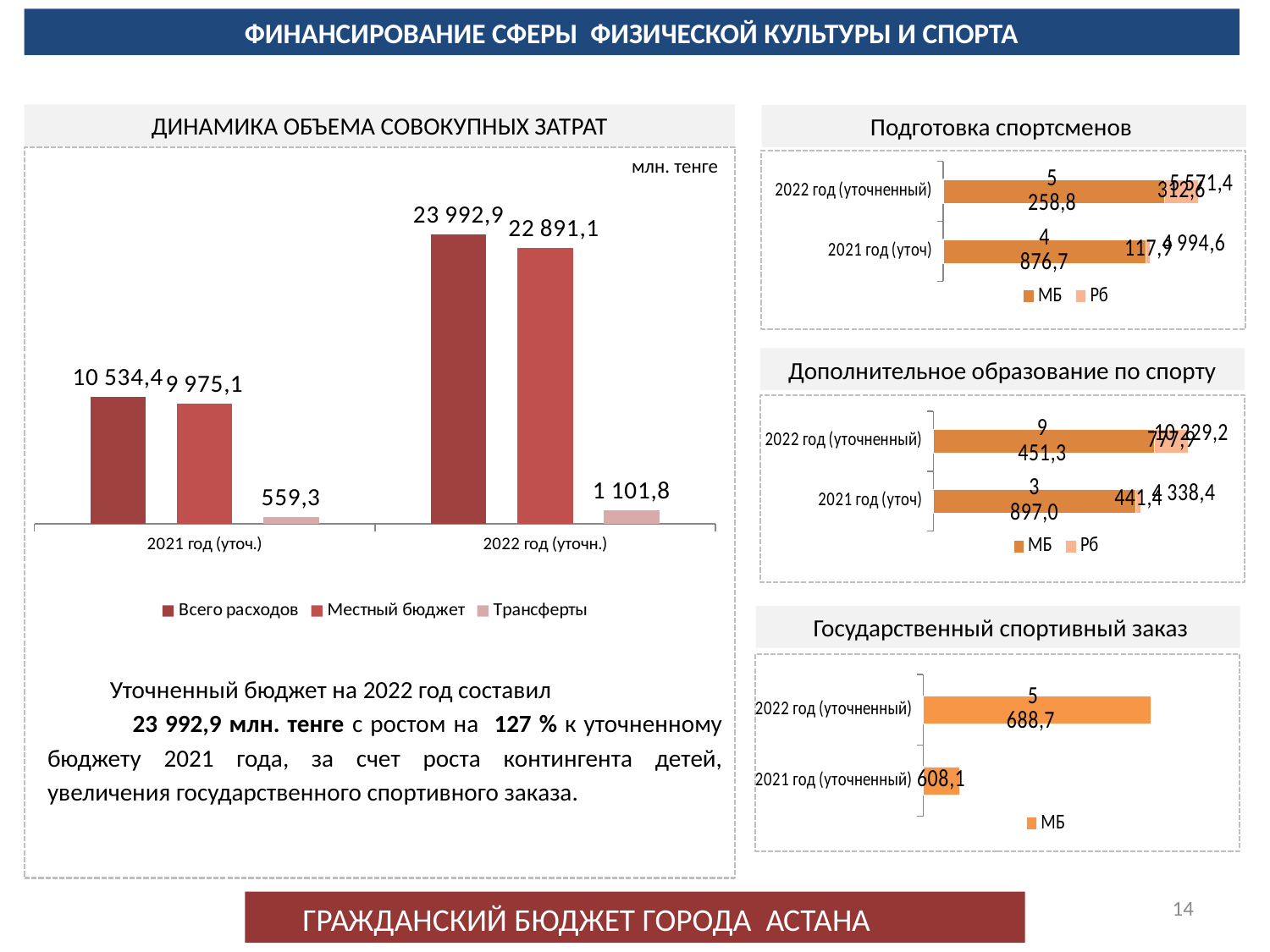
In the chart 'ДИНАМИКА ОБЪЕМА СОВОКУПНЫХ ЗАТРАТ', what is the difference between 'Всего расходов' for 2022 год (уточн.) and for 2021 год (уточ.)? 13 458,5 In the chart 'ДИНАМИКА ОБЪЕМА СОВОКУПНЫХ ЗАТРАТ', what is the value of 'Всего расходов' for 2022 год (уточн.)? 23 992,9 In the chart 'Дополнительное образование по спорту', what is the total of the stacked bar for 2022 год (уточненный)? 10 229,2 What kind of chart is 'ДИНАМИКА ОБЪЕМА СОВОКУПНЫХ ЗАТРАТ'? bar chart In the chart 'Подготовка спортсменов', what is the value of Рб for 2021 год (уточ)? 117,9 In the chart 'Дополнительное образование по спорту', what is the value of МБ for 2021 год (уточ)? 3 897,0 In the chart 'Государственный спортивный заказ', which year has the lower value? 2021 год (уточненный) In the chart 'ДИНАМИКА ОБЪЕМА СОВОКУПНЫХ ЗАТРАТ', how many series does the legend list? 3 In the chart 'Государственный спортивный заказ', what is the value for 2022 год (уточненный)? 5 688,7 In the chart 'ДИНАМИКА ОБЪЕМА СОВОКУПНЫХ ЗАТРАТ', does 'Местный бюджет' rise or fall from 2021 to 2022? rise In the chart 'Подготовка спортсменов', what is the value of МБ for 2022 год (уточненный)? 5 258,8 In the chart 'ДИНАМИКА ОБЪЕМА СОВОКУПНЫХ ЗАТРАТ', what is the value of 'Трансферты' for 2021 год (уточ.)? 559,3